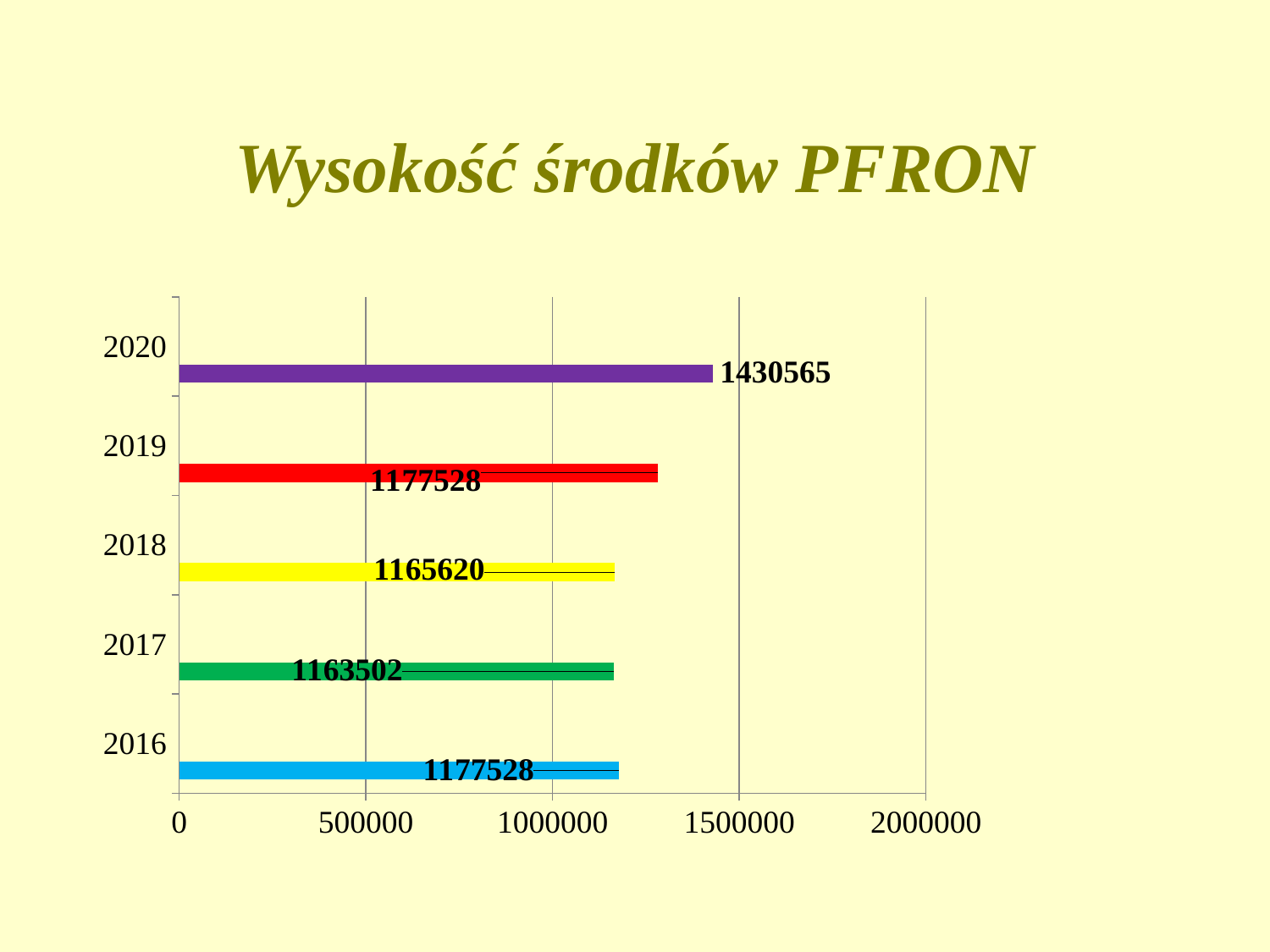
Which year has the lowest value according to the data labels? 2017 What is the value for 2016? 1177528 What is the value for 2018? 1165620 How many years are shown on the chart? 5 What is the title of the chart? Wysokość środków PFRON What is the difference between the values for 2020 and 2016? 253037 What is the value for 2017? 1163502 Is the value for 2017 greater or less than 1500000? less What is the value for 2020? 1430565 What kind of chart is shown on the slide? bar chart Which is larger, the value for 2020 or the value for 2017? 2020 Which year has the highest value? 2020